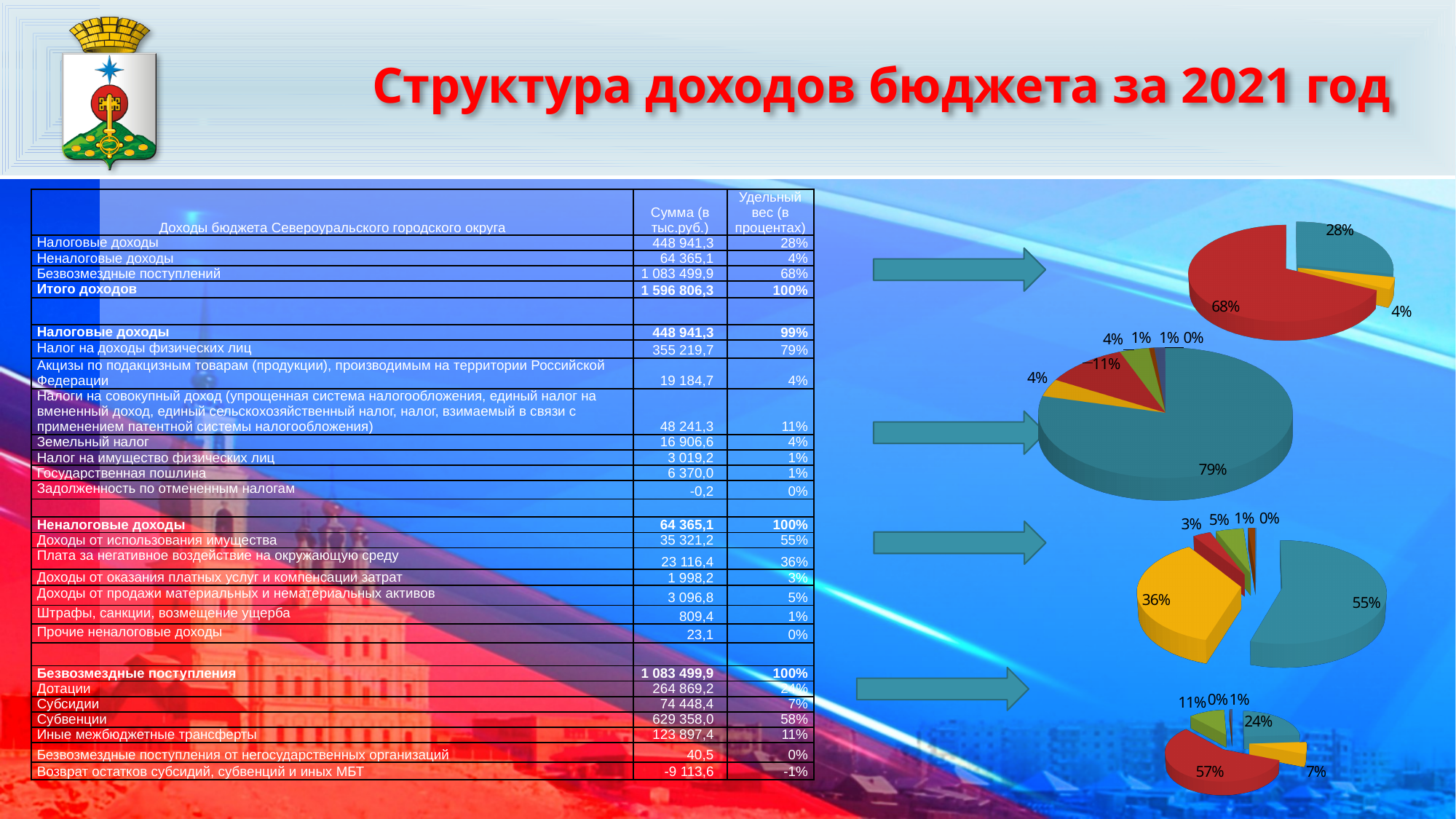
In the second pie chart from the top, what is the share of the red slice? 11% What type of chart is used for the four charts on the right side of the slide? pie chart In the second pie chart from the top, what is the share of the largest slice? 79% In the bottom pie chart, what is the share of the largest slice? 57% How many slices does the top pie chart have? 3 In the third pie chart from the top, what is the share of the yellow slice? 36% In the top pie chart, what is the share of the smallest slice? 4% In the third pie chart from the top, what is the difference between the 55% slice and the 36% slice? 19% In the top pie chart, what is the share of the largest slice? 68% In the top pie chart, what colour is the 68% slice? red How many pie charts are shown on the slide? 4